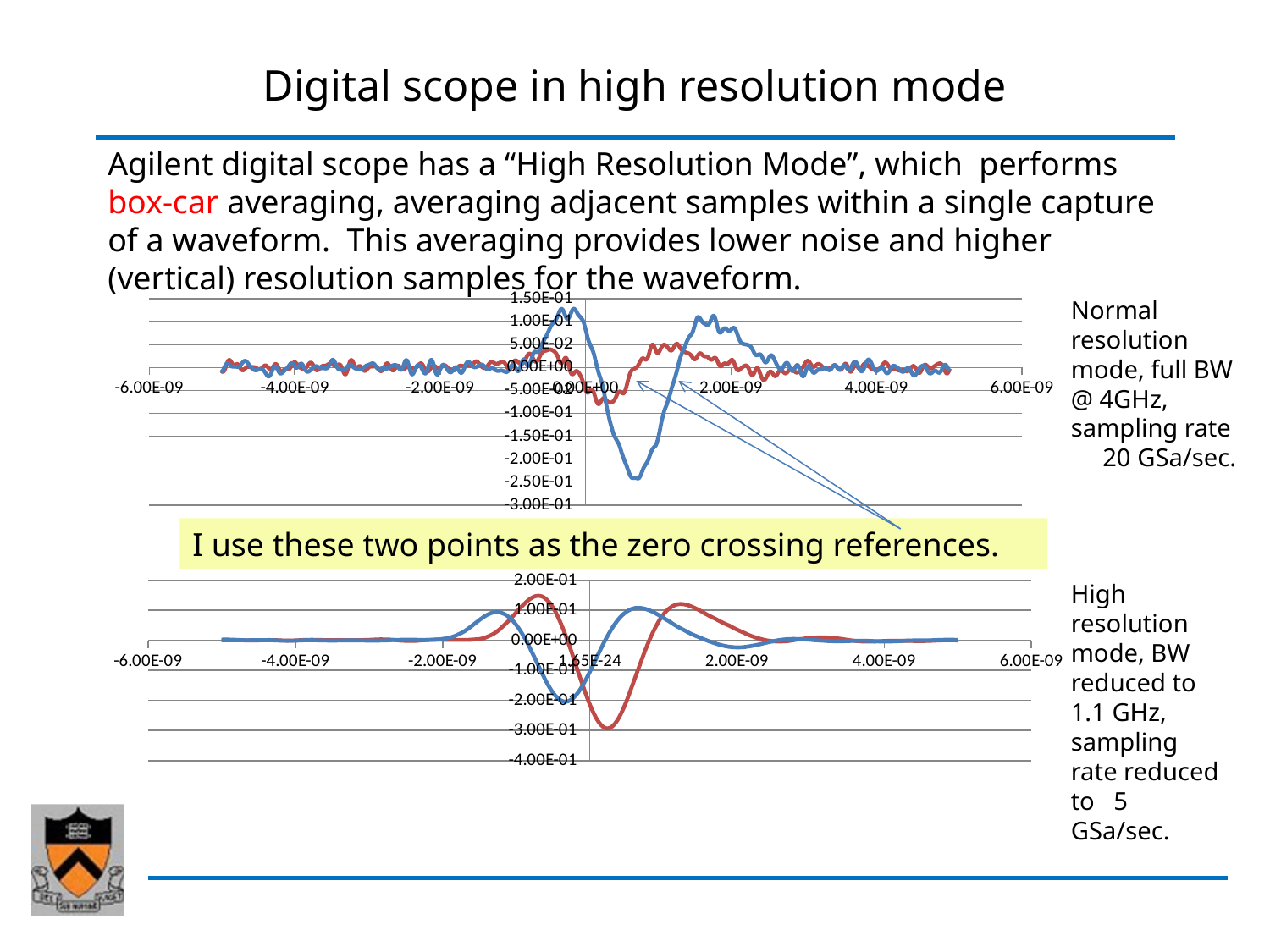
In the upper chart, which line reaches the higher peak value, the blue line or the red line? blue line How many lines are plotted in the lower chart? 2 What kind of chart is the upper chart on the slide? line chart In the lower chart, what is the highest value shown on the vertical axis? 2.00E-01 In the upper chart, what is the lowest value shown on the vertical axis? -3.00E-01 In the upper chart, is the minimum value of the blue line greater or less than -2.00E-01? less What kind of chart is the lower chart on the slide? line chart In the upper chart, which line reaches the lower minimum value, the blue line or the red line? blue line In the upper chart, is the peak value of the blue line greater or less than 1.00E-01? greater In the lower chart, is the minimum value of the red line greater or less than -2.00E-01? less How many lines are plotted in the upper chart? 2 In the lower chart, which line reaches the lower minimum value, the blue line or the red line? red line